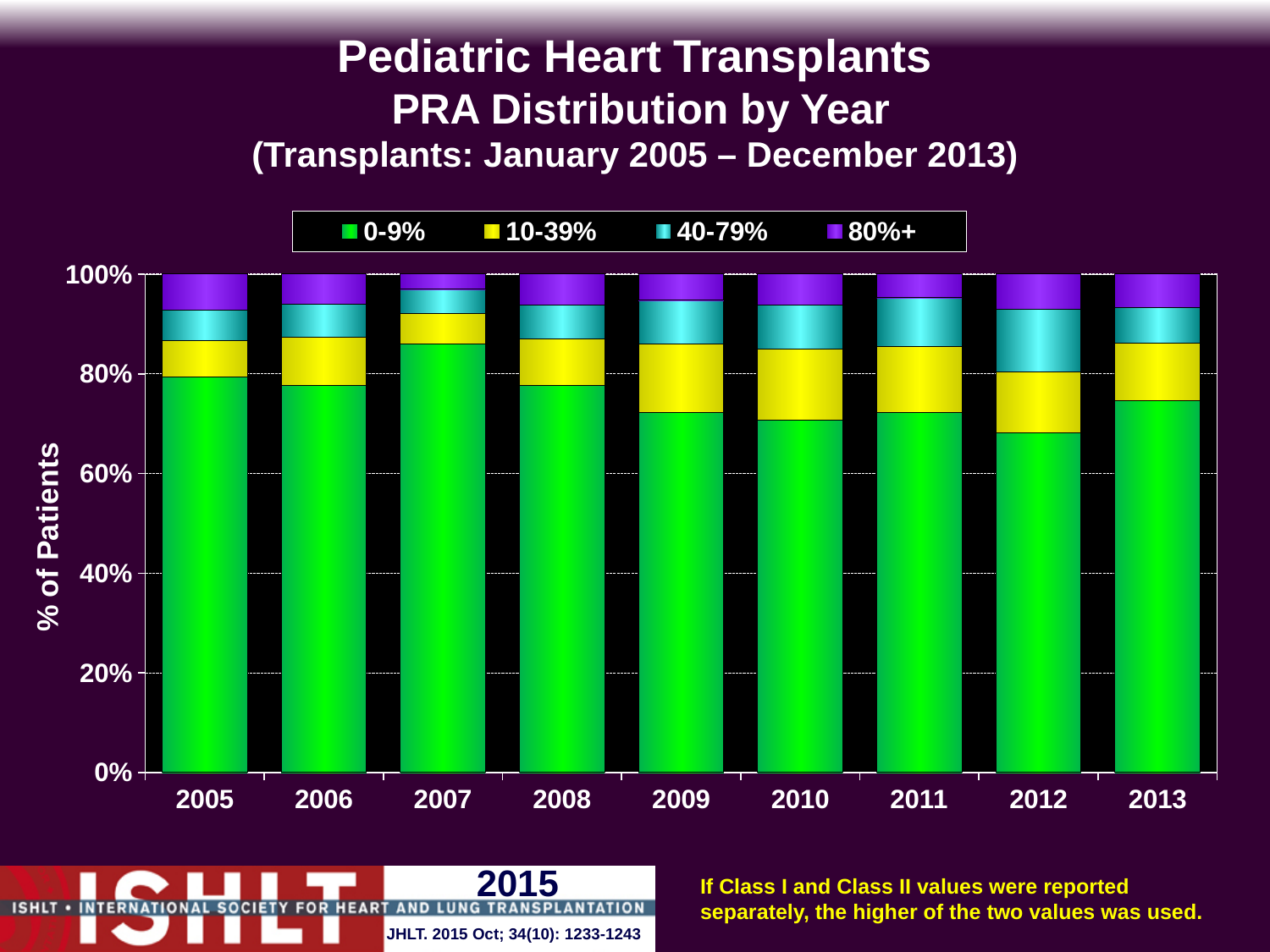
Does the 0-9% segment rise or fall from 2007 to 2012? fall What is the label on the y axis of the chart? % of Patients What is the total of the stacked bar for 2005? 100% What kind of chart is shown on the slide? Stacked bar chart How many years are shown along the x axis of the chart? 9 Is the 0-9% segment for 2012 greater or less than 80%? less Which year has the largest 0-9% PRA segment? 2007 Is the 0-9% segment for 2009 greater or less than 80%? less Which year has the smallest 0-9% PRA segment? 2012 Is the 0-9% segment for 2007 greater or less than 80%? greater How many series does the chart's legend list? 4 Which year has a larger 0-9% segment, 2007 or 2012? 2007